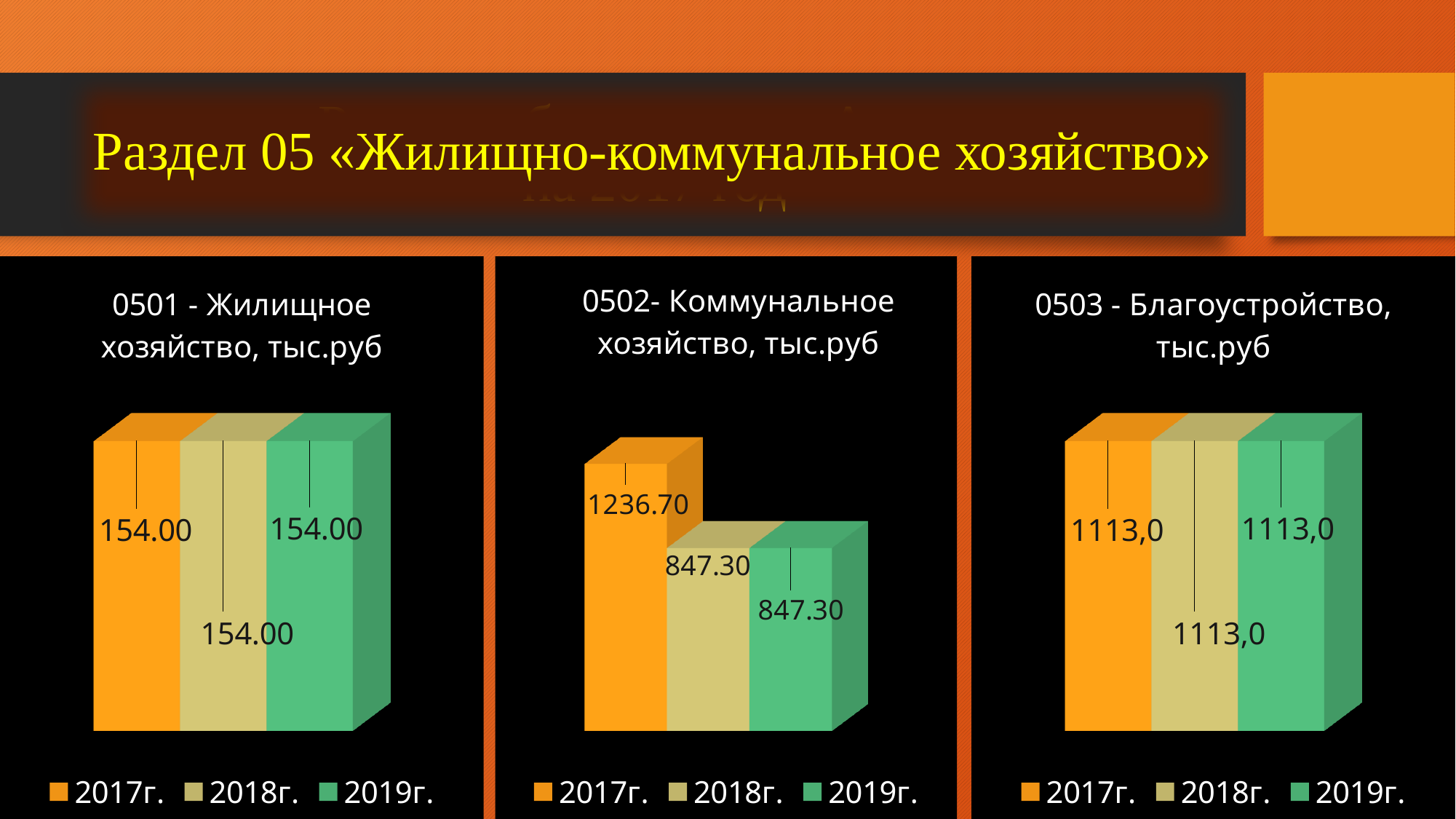
How many series does the legend list in the chart titled "0503 - Благоустройство, тыс.руб"? 3 In the chart titled "0502- Коммунальное хозяйство, тыс.руб", what is the value for 2018г.? 847.30 What kind of chart is the chart titled "0502- Коммунальное хозяйство, тыс.руб"? Bar chart In the chart titled "0502- Коммунальное хозяйство, тыс.руб", do the values rise or fall from 2017г. to 2018г.? Fall How many bars are plotted in the chart titled "0501 - Жилищное хозяйство, тыс.руб"? 3 In the chart titled "0501 - Жилищное хозяйство, тыс.руб", what is the value for 2017г.? 154.00 In the chart titled "0503 - Благоустройство, тыс.руб", what is the value for 2019г.? 1113,0 In the chart titled "0502- Коммунальное хозяйство, тыс.руб", which year has the highest value? 2017г. How many charts are shown on the slide? 3 In the chart titled "0502- Коммунальное хозяйство, тыс.руб", which is larger, the value for 2017г. or the value for 2019г.? 2017г. In the chart titled "0502- Коммунальное хозяйство, тыс.руб", what is the value for 2017г.? 1236.70 In the chart titled "0502- Коммунальное хозяйство, тыс.руб", what is the difference between the 2017г. value and the 2018г. value? 389.40